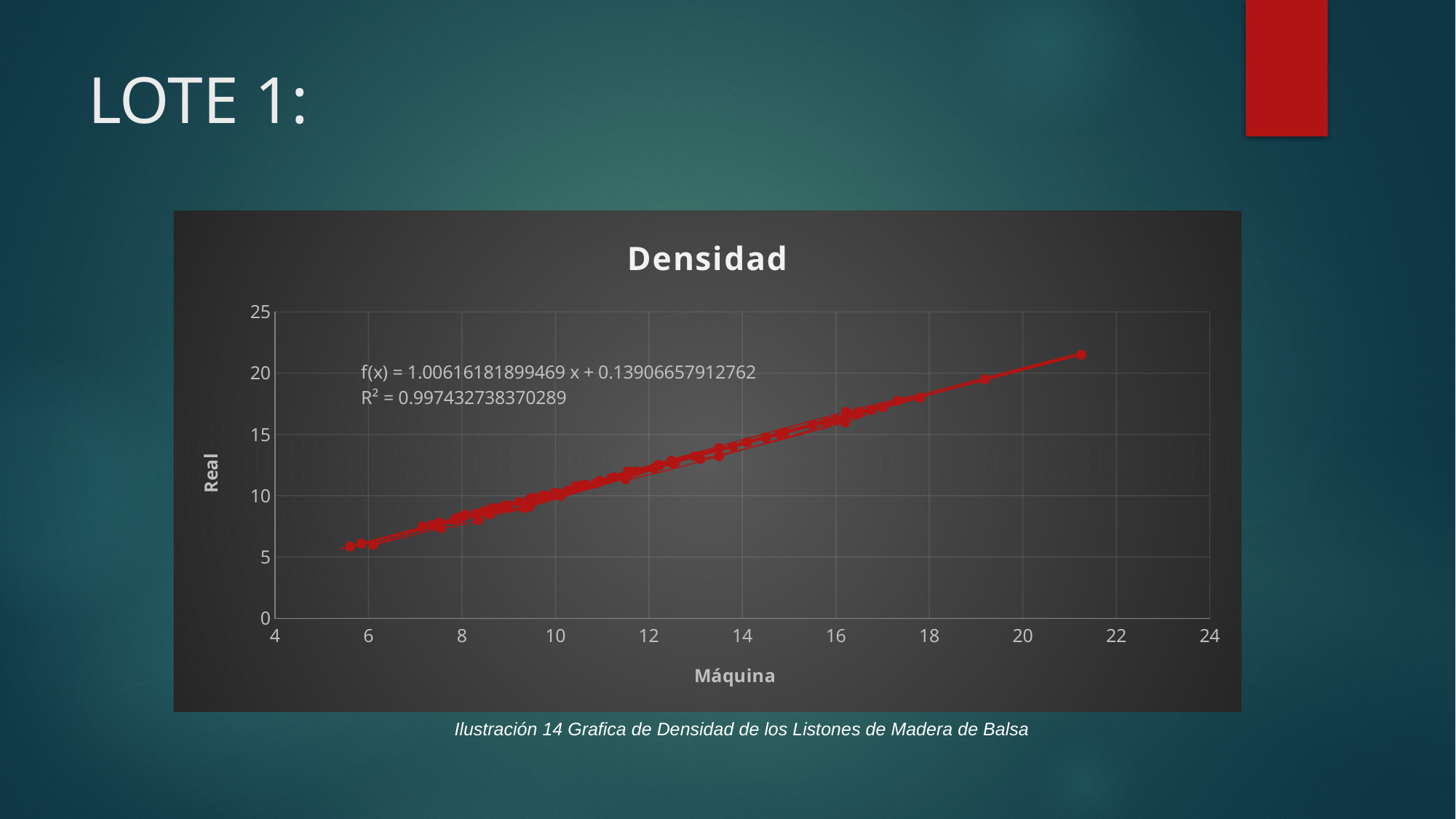
What is the trendline equation printed on the chart? f(x) = 1.00616181899469 x + 0.13906657912762 What is the label of the horizontal axis of the chart? Máquina Is the Máquina value of the rightmost point greater or less than 20? greater Is the Real value of the point with the lowest Máquina value greater or less than 10? less What is the R² value printed on the chart? 0.997432738370289 Do the Real values rise or fall as the Máquina values increase along the x axis? Rise What is the title of the chart? Densidad What kind of chart is shown on the slide? Scatter chart What is the highest value shown on the horizontal axis of the chart? 24 What is the highest value shown on the vertical axis of the chart? 25 Is the Real value of the point with the highest Máquina value greater or less than 20? greater